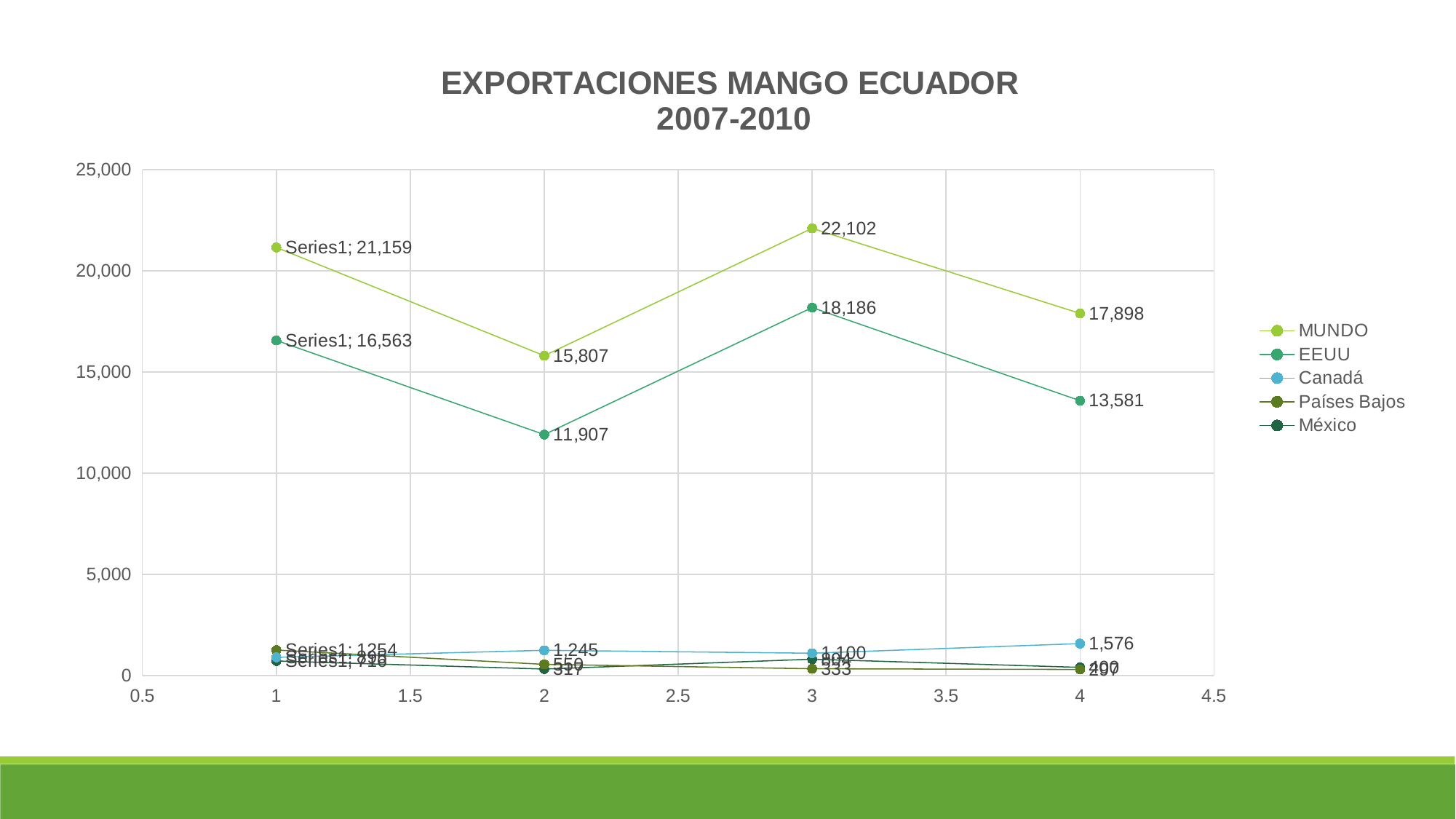
What is the title of the chart? EXPORTACIONES MANGO ECUADOR 2007-2010 Which series has the higher value at x = 4, MUNDO or EEUU? MUNDO What is the difference between the MUNDO and EEUU values at x = 3? 3,916 At which x value does the MUNDO series reach its highest value? 3 What is the value of the MUNDO series at x = 3? 22,102 What is the value of the EEUU series at x = 4? 13,581 What is the value of the MUNDO series at x = 1? 21,159 How many series does the legend list? 5 What is the value of the Canadá series at x = 4? 1,576 What is the value of the EEUU series at x = 2? 11,907 What kind of chart is shown on the slide? line chart At which x value does the EEUU series reach its lowest value? 2